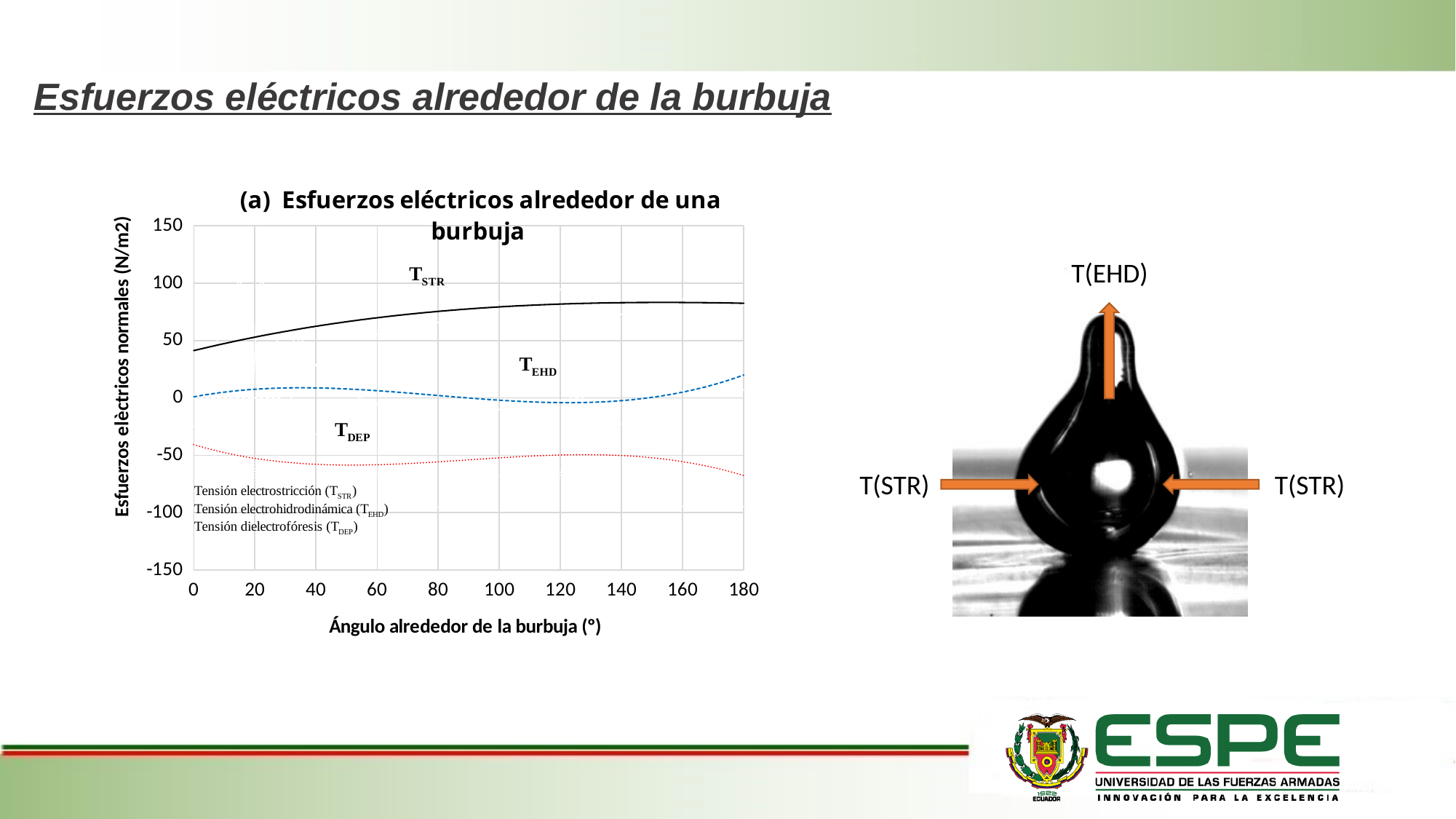
At 180°, which is larger, T_STR or T_DEP? T_STR Is the value of T_EHD at 180° greater or less than 0? greater What is the title of the x axis? Ángulo alrededor de la burbuja (°) Does the T_STR curve rise or fall between 0° and 140°? rise How many series are plotted on the chart? 3 What kind of chart is shown on the slide? line chart Is the value of T_DEP at 180° greater or less than -50? less Is the value of T_STR at 180° greater or less than 100? less Which series has the lowest values across the whole angle range? T_DEP Which series has the highest values across the whole angle range? T_STR